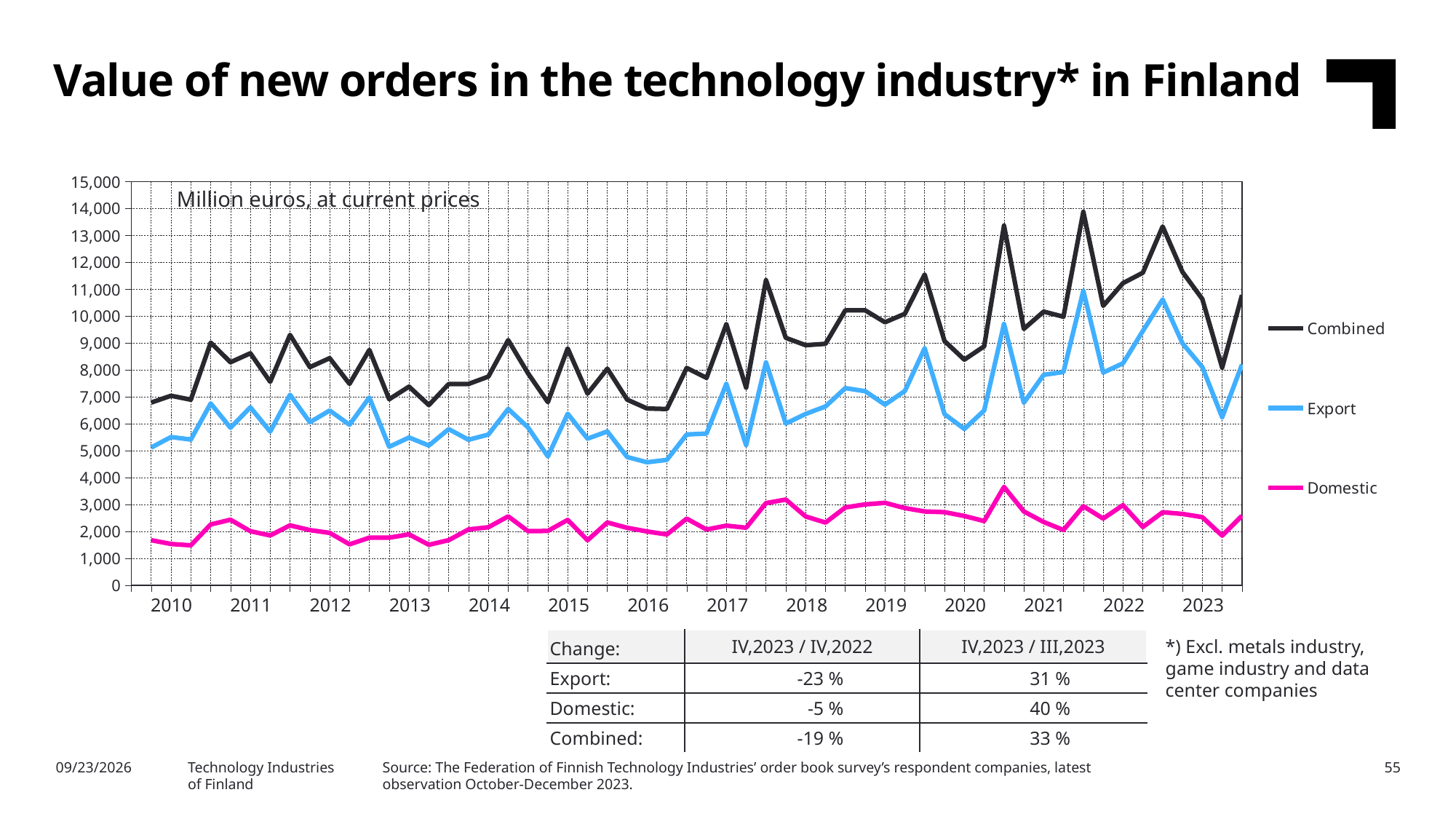
What kind of chart is shown on the slide? Line chart Which series in the chart has the lowest values throughout the period? Domestic How many years are labelled on the x axis of the chart? 14 Does the Combined series overall rise or fall from 2010 to 2023? Rise What unit is stated inside the chart area? Million euros, at current prices Is the lowest value of the Export series in 2016 greater or less than 5,000? less Which series in the chart has the highest values throughout the period? Combined Is the peak value of the Combined series in 2021 greater or less than 13,000? greater How many series does the chart's legend list? 3 Is the peak value of the Export series in 2021 greater or less than 10,000? greater Which is larger at the end of 2023: the Export value or the Domestic value? Export